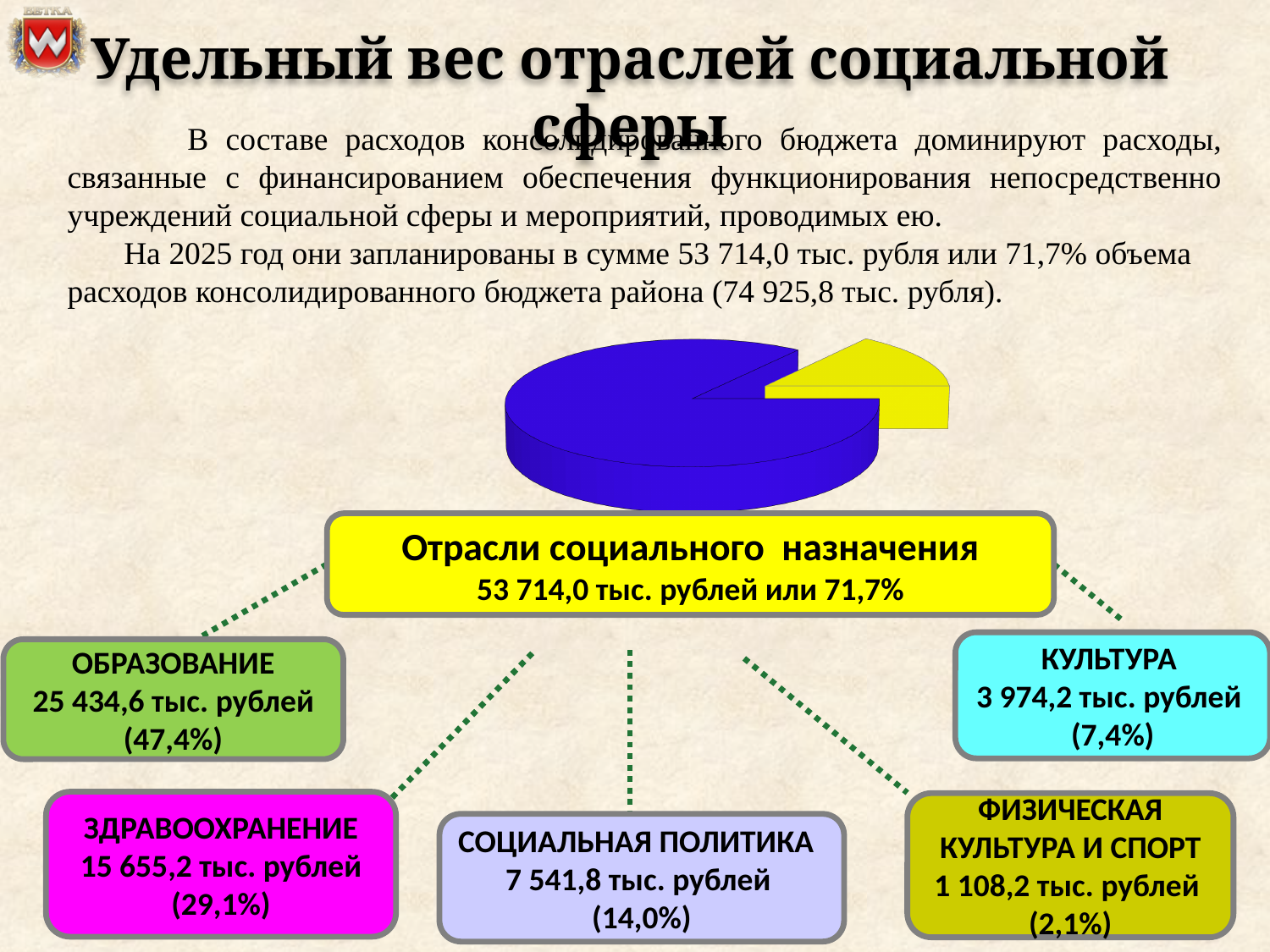
Which slice of the pie chart is pulled out (exploded) from the rest of the pie? the yellow slice Is the yellow slice's share of the pie greater or less than 50%? less What colour is the largest slice of the pie chart? blue Which slice of the pie chart is larger, the blue one or the yellow one? the blue one Is the blue slice's share of the pie greater or less than 50%? greater Does the pie chart have a legend? No What kind of chart is shown on the slide? pie chart How many slices does the pie chart have? 2 What colour is the smallest slice of the pie chart? yellow